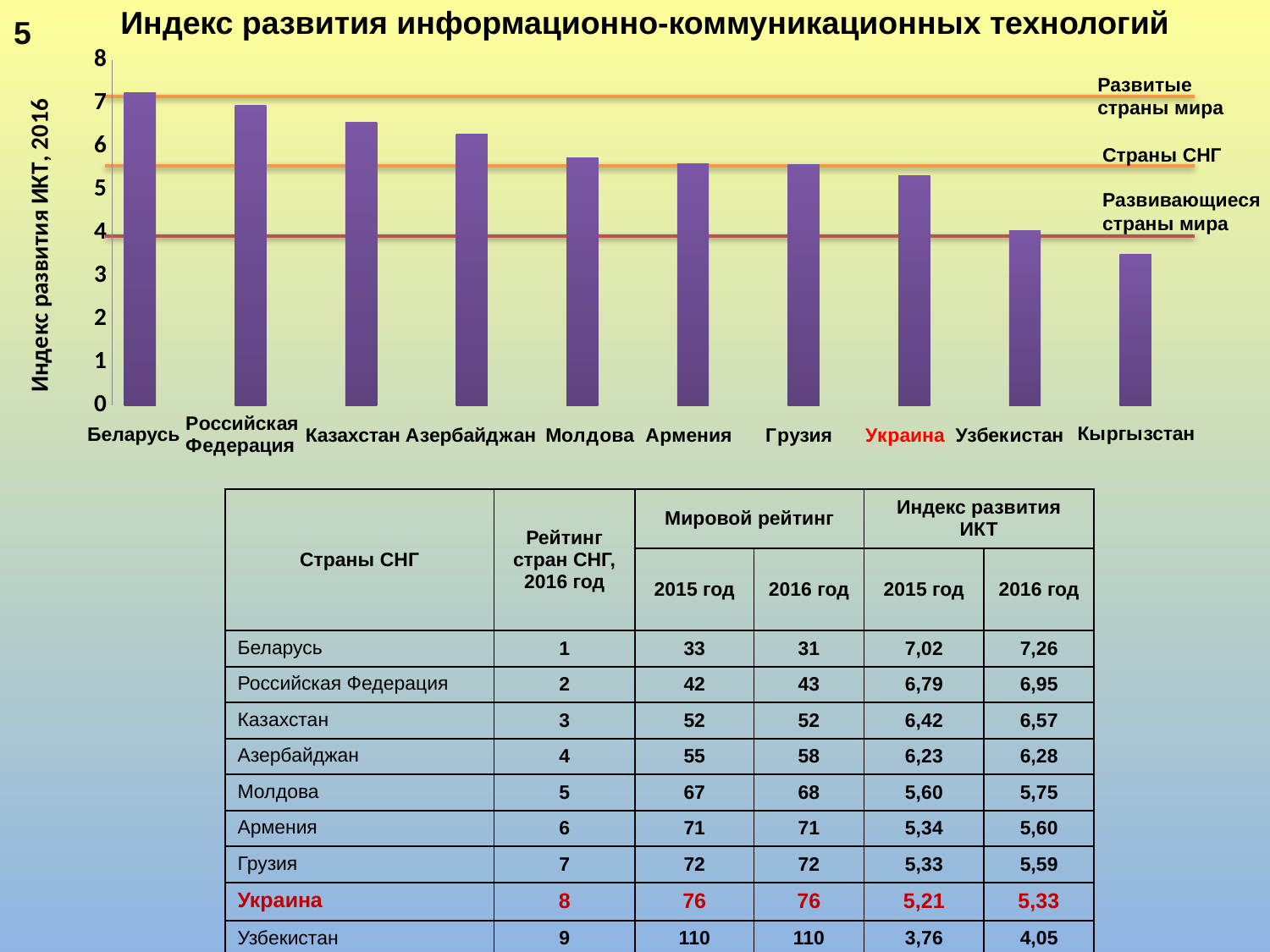
Which country has the lowest bar in the chart? Кыргызстан Which bar is taller, Казахстан or Молдова? Казахстан According to the table, what is the ICT development index for Беларусь in 2016? 7,26 How many countries are plotted in the bar chart? 10 Do the bar values rise or fall from left to right along the x axis? fall What kind of chart is shown on the slide? bar chart Is the value for Украина greater or less than 5? greater Is the value for Азербайджан greater or less than 6? greater Using the 2016 index values in the table, what is the difference between Беларусь and Украина? 1,93 Which country has the highest bar in the chart? Беларусь Which country label on the x axis is highlighted in red? Украина Is the value for Кыргызстан greater or less than 4? less